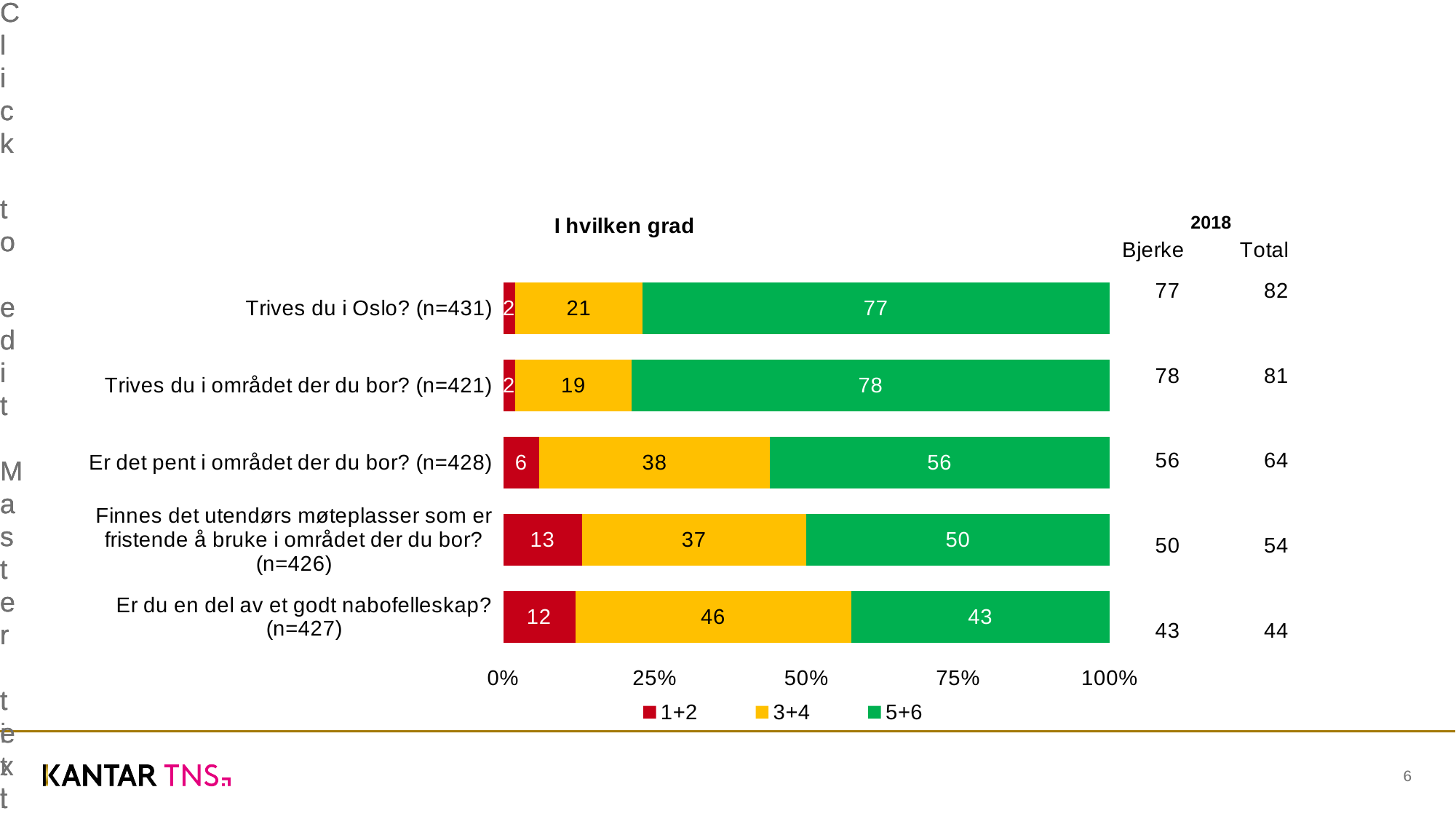
What is the value of the 1+2 series for "Finnes det utendørs møteplasser som er fristende å bruke i området der du bor? (n=426)"? 13 Which is larger: the 1+2 value for "Er det pent i området der du bor? (n=428)" or the 1+2 value for "Er du en del av et godt nabofelleskap? (n=427)"? Er du en del av et godt nabofelleskap? (n=427) Which category has the lowest value in the 5+6 series? Er du en del av et godt nabofelleskap? (n=427) How many series does the legend list? 3 What kind of chart is shown on the slide? Stacked bar chart Which category has the highest value in the 5+6 series? Trives du i området der du bor? (n=421) What is the total of the stacked bar for "Er det pent i området der du bor? (n=428)"? 100 What is the value of the 3+4 series for "Er du en del av et godt nabofelleskap? (n=427)"? 46 What is the title of the chart? I hvilken grad What is the difference between the 3+4 values for "Er det pent i området der du bor? (n=428)" and "Trives du i Oslo? (n=431)"? 17 How many categories (questions) are shown in the chart? 5 What is the value of the 5+6 series for "Trives du i Oslo? (n=431)"? 77